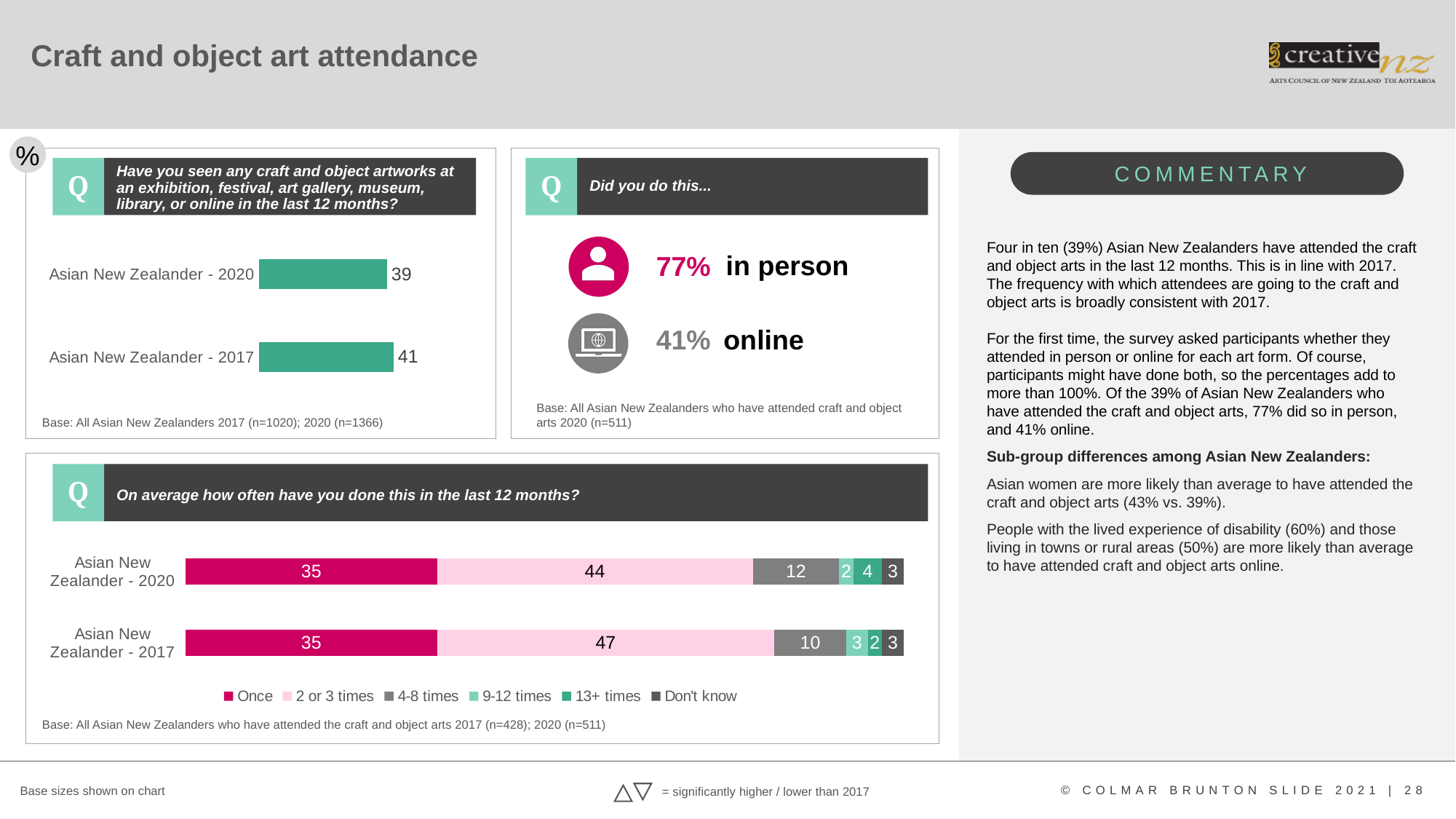
What kind of chart is the top-left chart on whether respondents have seen craft and object artworks? bar chart In the bottom chart on how often respondents have done this in the last 12 months, what is the value for '2 or 3 times' for Asian New Zealander - 2020? 44 In the top-left chart on whether respondents have seen craft and object artworks, which year has the higher value, 2020 or 2017? 2017 In the bottom chart on how often respondents have done this, what is the difference between the '2 or 3 times' values for 2017 and 2020? 3 In the bottom chart on how often respondents have done this in the last 12 months, what is the value for '4-8 times' for Asian New Zealander - 2017? 10 In the top-left chart on whether respondents have seen craft and object artworks, what is the difference between the 2017 and 2020 values? 2 In the bottom chart on how often respondents have done this in the last 12 months, what is the value for '13+ times' for Asian New Zealander - 2020? 4 In the top-left chart on whether respondents have seen craft and object artworks in the last 12 months, what is the value for Asian New Zealander - 2017? 41 In the bottom chart on how often respondents have done this, which frequency category has the highest value for Asian New Zealander - 2017? 2 or 3 times In the top-left chart on whether respondents have seen craft and object artworks in the last 12 months, what is the value for Asian New Zealander - 2020? 39 In the bottom chart on how often respondents have done this, what is the total of the stacked bar for Asian New Zealander - 2020? 100 How many series does the legend of the bottom chart on how often respondents have done this list? 6